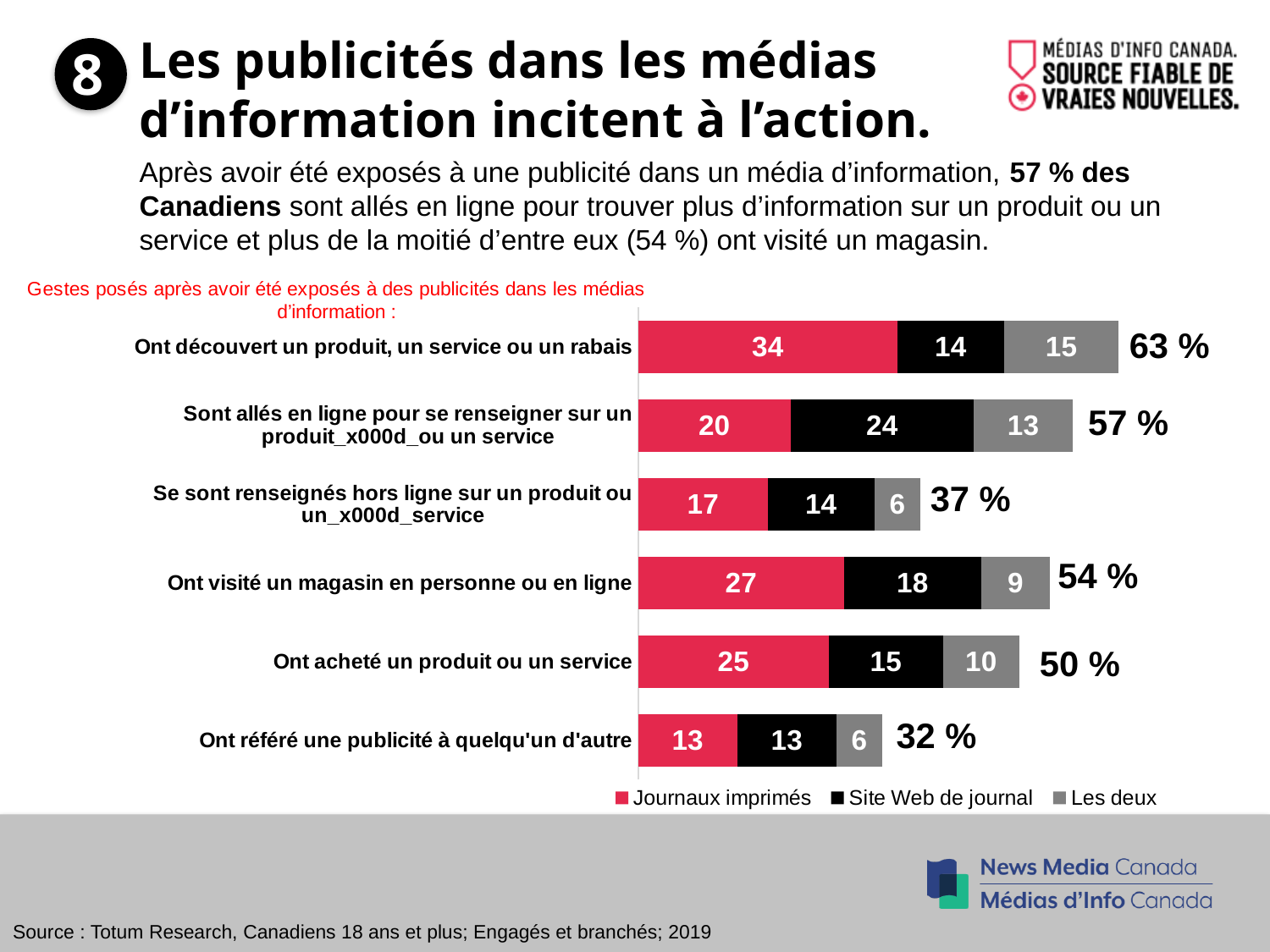
What is the value for "Les deux" in the category "Ont acheté un produit ou un service"? 10 What is the value for "Journaux imprimés" in the category "Ont découvert un produit, un service ou un rabais"? 34 How many categories (actions) are plotted in the chart? 6 What is the difference between the "Journaux imprimés" value and the "Site Web de journal" value for "Ont découvert un produit, un service ou un rabais"? 20 Which colour represents the "Site Web de journal" series in the chart? Black What is the value for "Site Web de journal" in the category "Sont allés en ligne pour se renseigner sur un produit ou un service"? 24 What kind of chart is shown on the slide? Stacked bar chart For "Se sont renseignés hors ligne sur un produit ou un service", which is larger: the "Journaux imprimés" value or the "Site Web de journal" value? Journaux imprimés How many series does the legend list? 3 Which category has the lowest total? Ont référé une publicité à quelqu'un d'autre Which category has the highest total? Ont découvert un produit, un service ou un rabais What is the total shown for the bar "Ont visité un magasin en personne ou en ligne"? 54 %